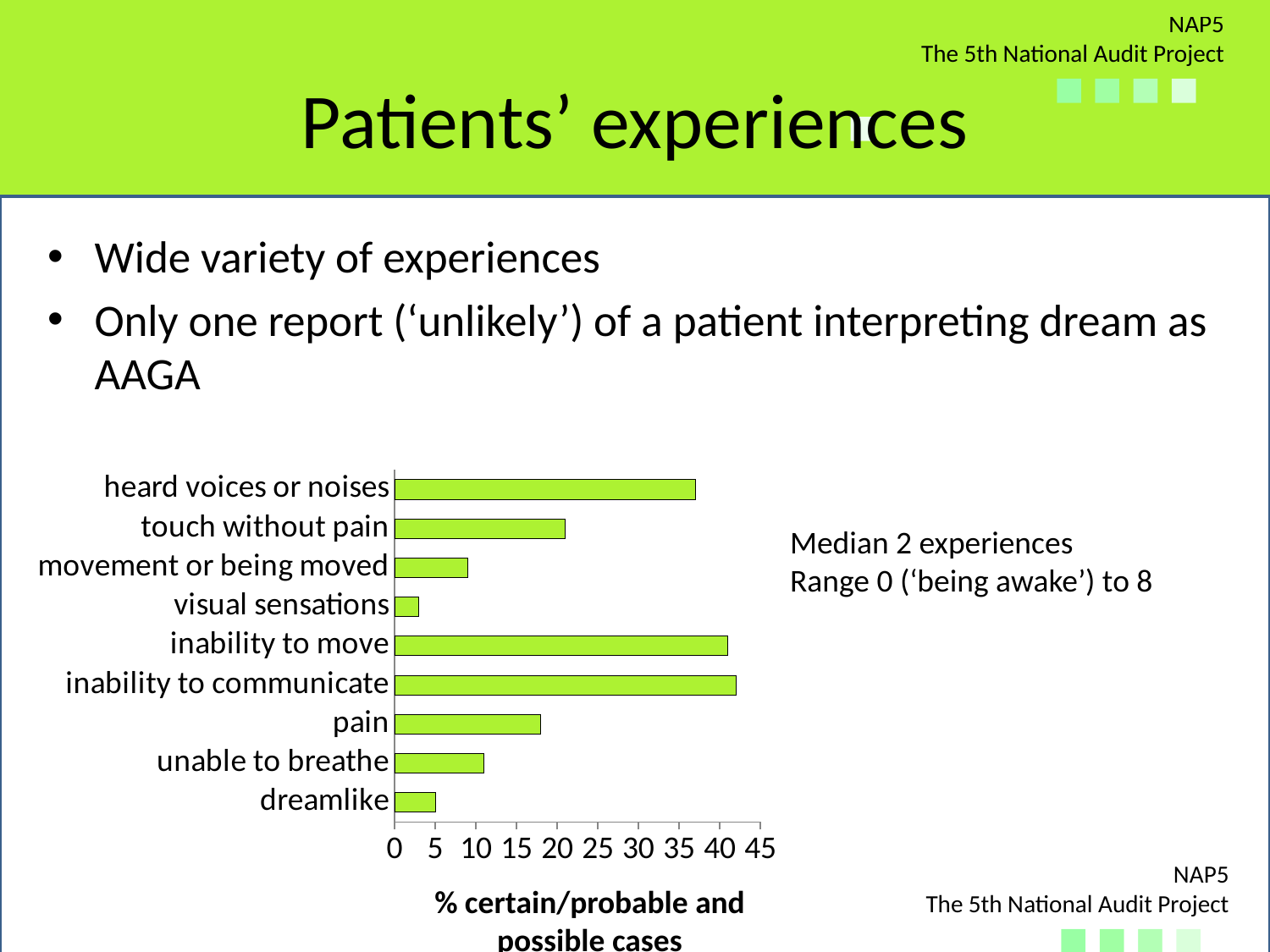
Is the value for 'movement or being moved' greater or less than 15? less How many categories of patient experience are plotted in the chart? 9 Is the value for 'dreamlike' greater or less than 10? less Is the value for 'touch without pain' greater or less than 15? greater Which has a larger value, 'movement or being moved' or 'visual sensations'? movement or being moved What kind of chart is shown on the slide? bar chart What is the title of the horizontal axis of the chart? % certain/probable and possible cases Which category has the lowest value in the chart? visual sensations Which has a larger value, 'pain' or 'unable to breathe'? pain Which has a larger value, 'heard voices or noises' or 'touch without pain'? heard voices or noises